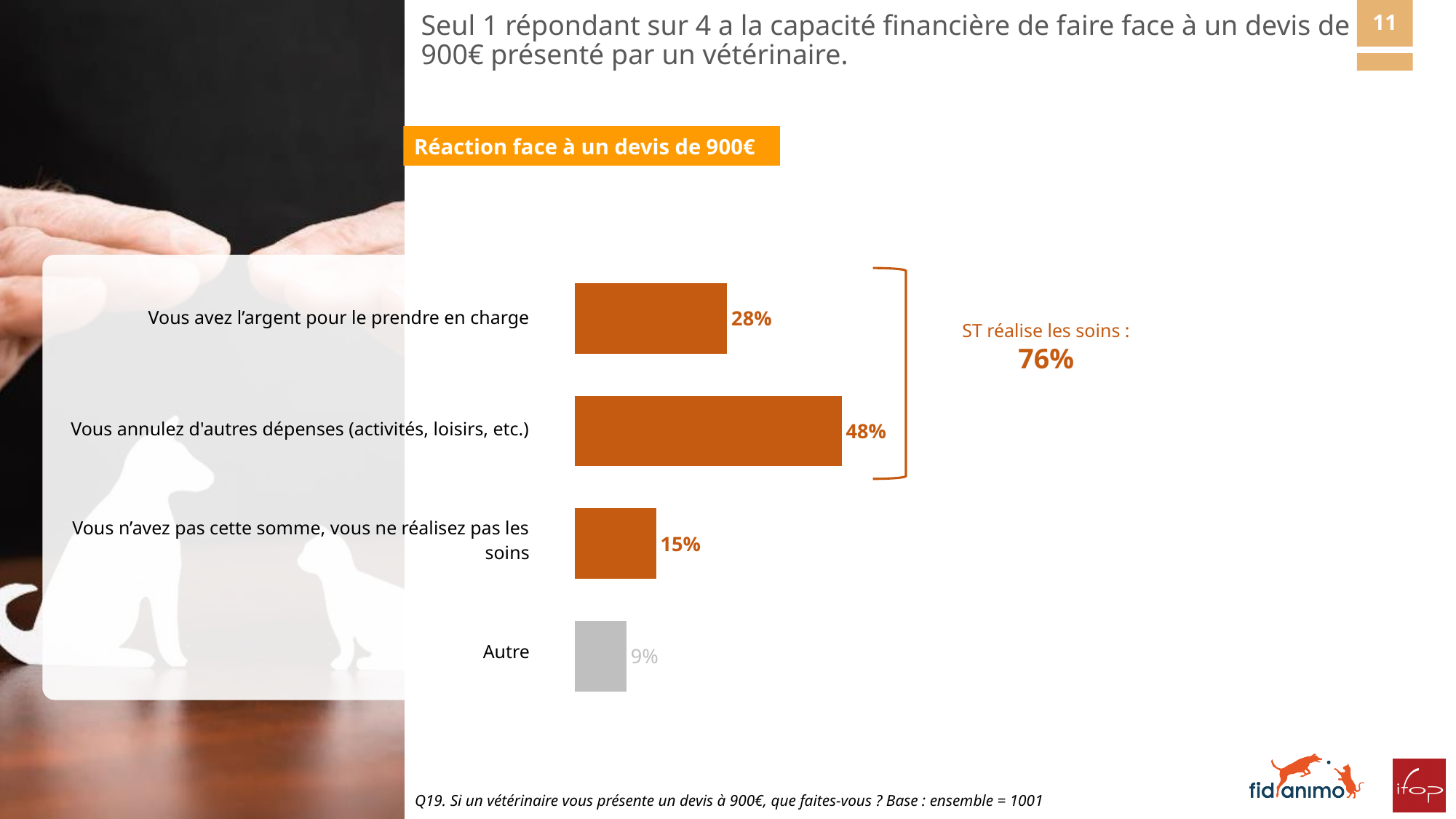
Which category has the lowest value? Autre What is the value for "Vous avez l'argent pour le prendre en charge"? 28% How many categories are shown in the chart? 4 Which is larger: "Vous n'avez pas cette somme, vous ne réalisez pas les soins" or "Autre"? Vous n'avez pas cette somme, vous ne réalisez pas les soins What is the title of the chart? Réaction face à un devis de 900€ What is the difference between "Vous annulez d'autres dépenses" and "Vous avez l'argent pour le prendre en charge"? 20% What is the "ST réalise les soins" value shown next to the chart? 76% Which category has the highest value? Vous annulez d'autres dépenses (activités, loisirs, etc.) What is the value for "Autre"? 9% What is the value for "Vous annulez d'autres dépenses (activités, loisirs, etc.)"? 48% What is the value for "Vous n'avez pas cette somme, vous ne réalisez pas les soins"? 15% What kind of chart is shown on the slide? Bar chart